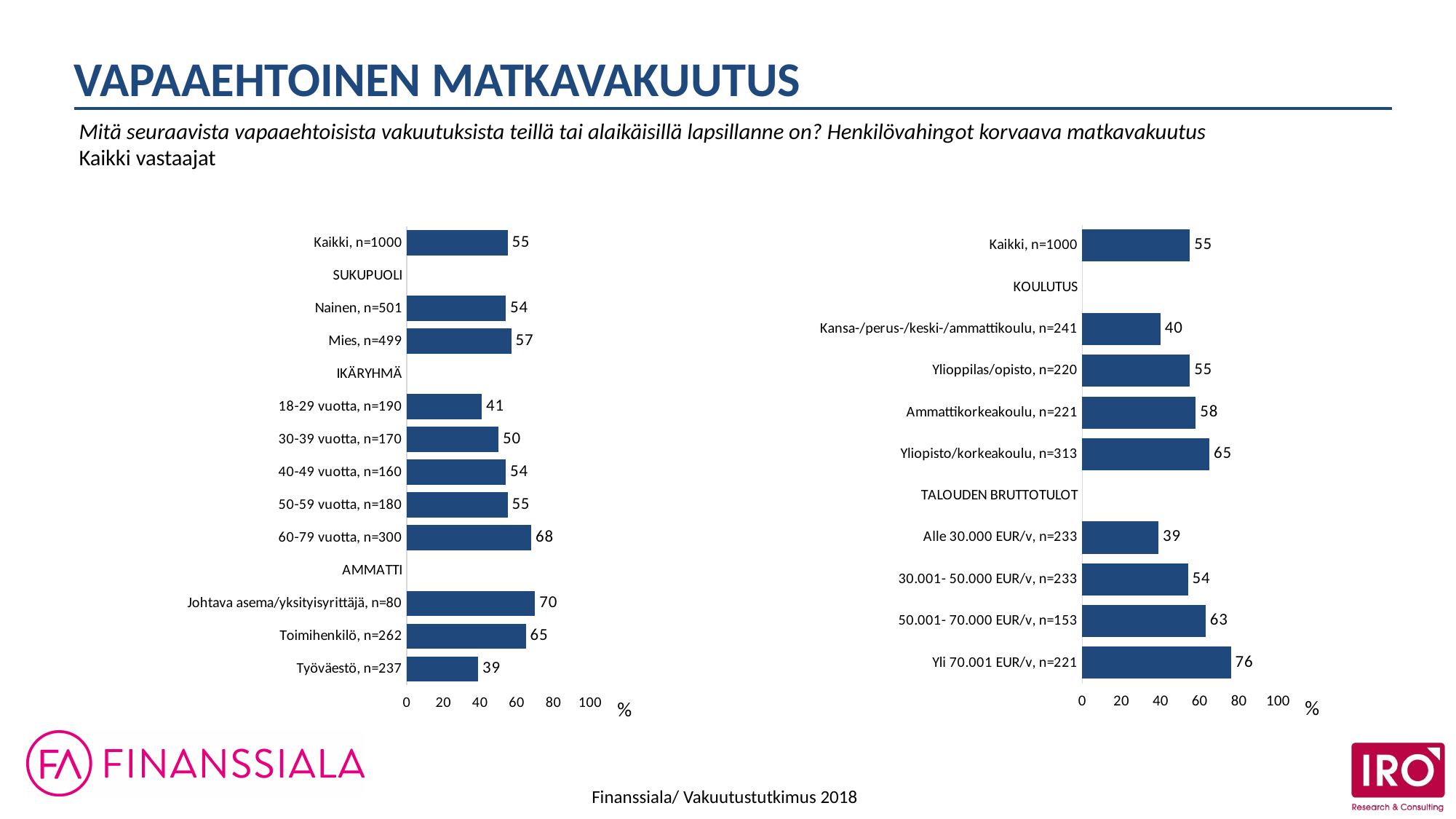
In the left chart, which is larger: the value for Toimihenkilö, n=262 or the value for 50-59 vuotta, n=180? Toimihenkilö, n=262 In the left chart, which category has the lowest value? Työväestö, n=237 In the right chart, which category has the highest value? Yli 70.001 EUR/v, n=221 In the right chart, what is the value for Yliopisto/korkeakoulu, n=313? 65 In the left chart, which category has the highest value? Johtava asema/yksityisyrittäjä, n=80 In the right chart, is the value for Kansa-/perus-/keski-/ammattikoulu, n=241 greater or less than 60? less What kind of chart is the left chart? Bar chart In the right chart, what is the difference between the values for Yli 70.001 EUR/v, n=221 and Alle 30.000 EUR/v, n=233? 37 In the left chart, what is the value for 18-29 vuotta, n=190? 41 In the right chart, what is the value for Alle 30.000 EUR/v, n=233? 39 In the left chart, what is the value for Mies, n=499? 57 In the left chart, what is the difference between the values for 60-79 vuotta, n=300 and 18-29 vuotta, n=190? 27